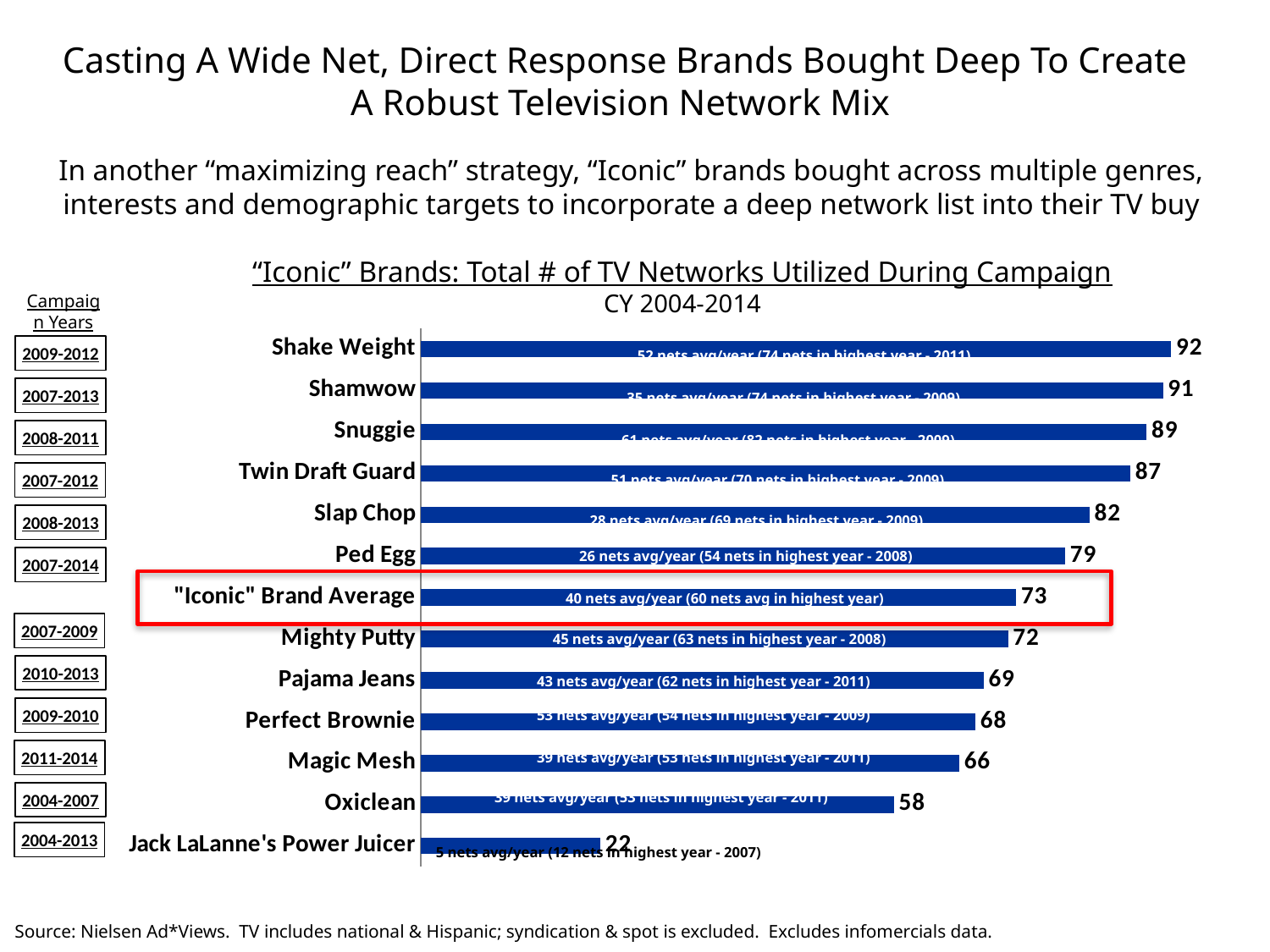
Which brand has the highest total number of TV networks utilized? Shake Weight What is the value shown for Ped Egg? 79 Which has a larger value, Pajama Jeans or Magic Mesh? Pajama Jeans What is the difference between the values for Shake Weight and Jack LaLanne's Power Juicer? 70 What is the total number of TV networks utilized by Shake Weight? 92 What time period is given in the chart's subtitle? CY 2004-2014 What is the value shown for Oxiclean? 58 What is the value shown for the "Iconic" Brand Average? 73 What is the difference between the values for Snuggie and Slap Chop? 7 Which brand has the lowest total number of TV networks utilized? Jack LaLanne's Power Juicer How many bars are plotted in the chart? 13 What type of chart is shown on the slide? Bar chart